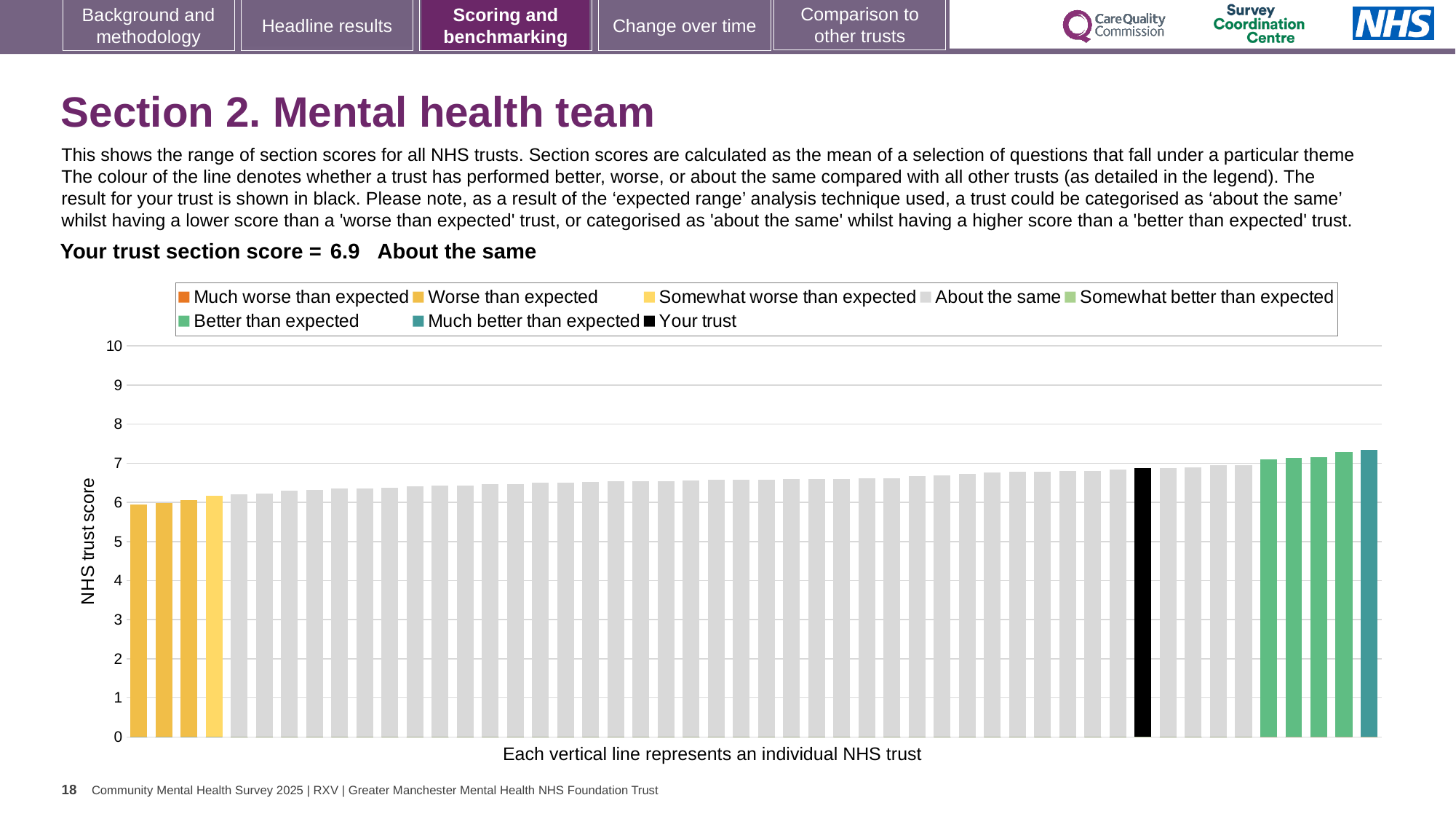
Which category is the trust's section score placed in, according to the text above the chart? About the same Do the bar values rise or fall from left to right across the chart? Rise Is the value of the tallest bar greater or less than 8? less How many entries does the chart legend list? 8 What colour is used for the bar representing 'Your trust'? Black What type of chart is shown on the slide? Bar chart Is the value of the leftmost bar greater or less than 5? greater What is the trust section score printed on the slide? 6.9 Is the value of the black 'Your trust' bar greater or less than 5? greater Which bar is the highest: the leftmost bar or the rightmost bar? The rightmost bar Which is larger: the black 'Your trust' bar or the leftmost bar? The black 'Your trust' bar What is the title of the vertical axis? NHS trust score